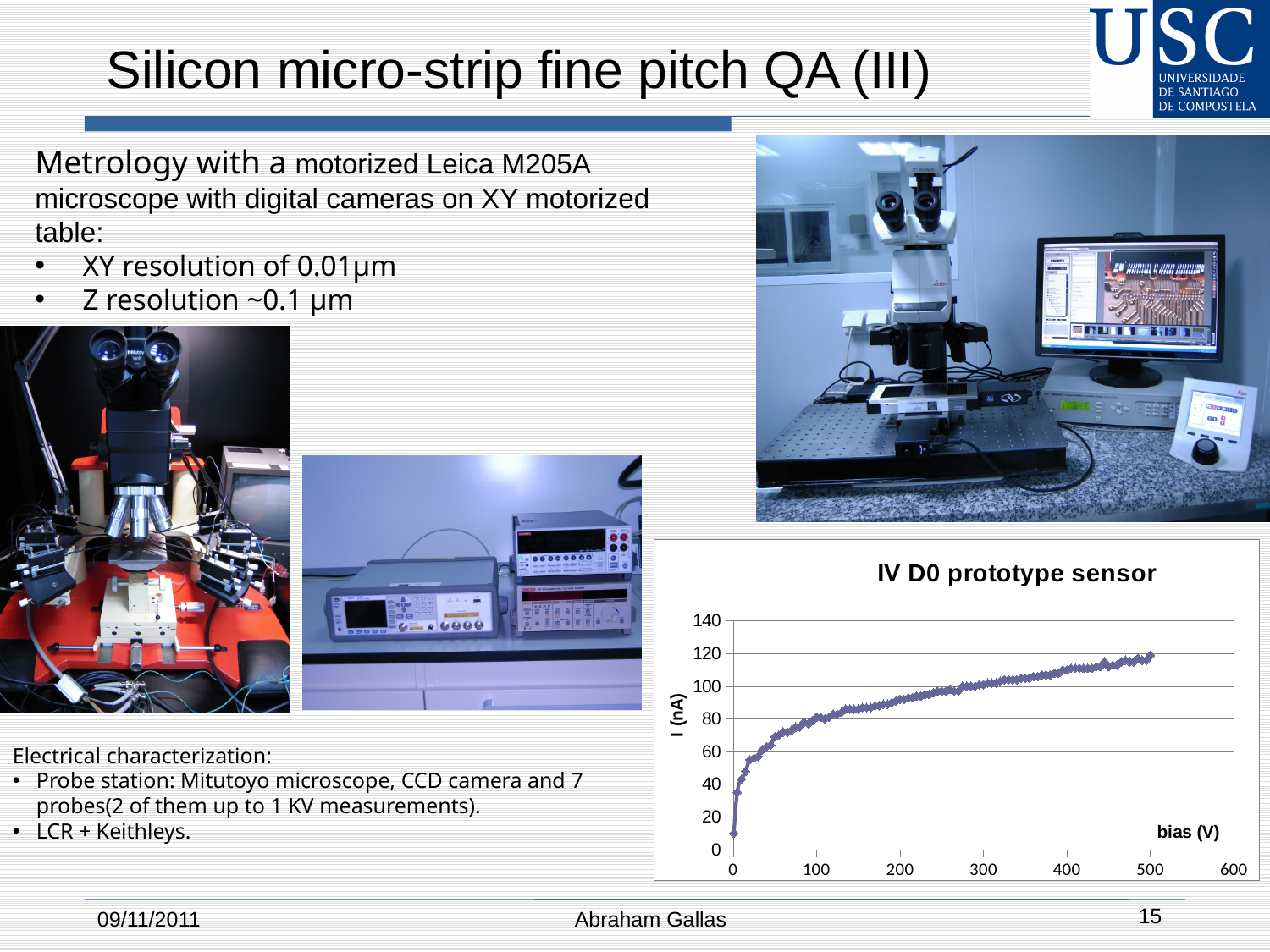
What kind of chart is the IV D0 prototype sensor chart? scatter chart In the IV D0 prototype sensor chart, is the current at a bias of 400 V greater or less than 120 nA? less In the IV D0 prototype sensor chart, is the current higher at a bias of 500 V or at a bias of 100 V? 500 V In the IV D0 prototype sensor chart, is the current at a bias of 100 V greater or less than 100 nA? less In the IV D0 prototype sensor chart, is the current at a bias of 200 V greater or less than 80 nA? greater What is the label of the vertical axis in the IV D0 prototype sensor chart? I (nA) What is the title of the chart on the slide? IV D0 prototype sensor In the IV D0 prototype sensor chart, does the current rise or fall as the bias voltage increases? rise